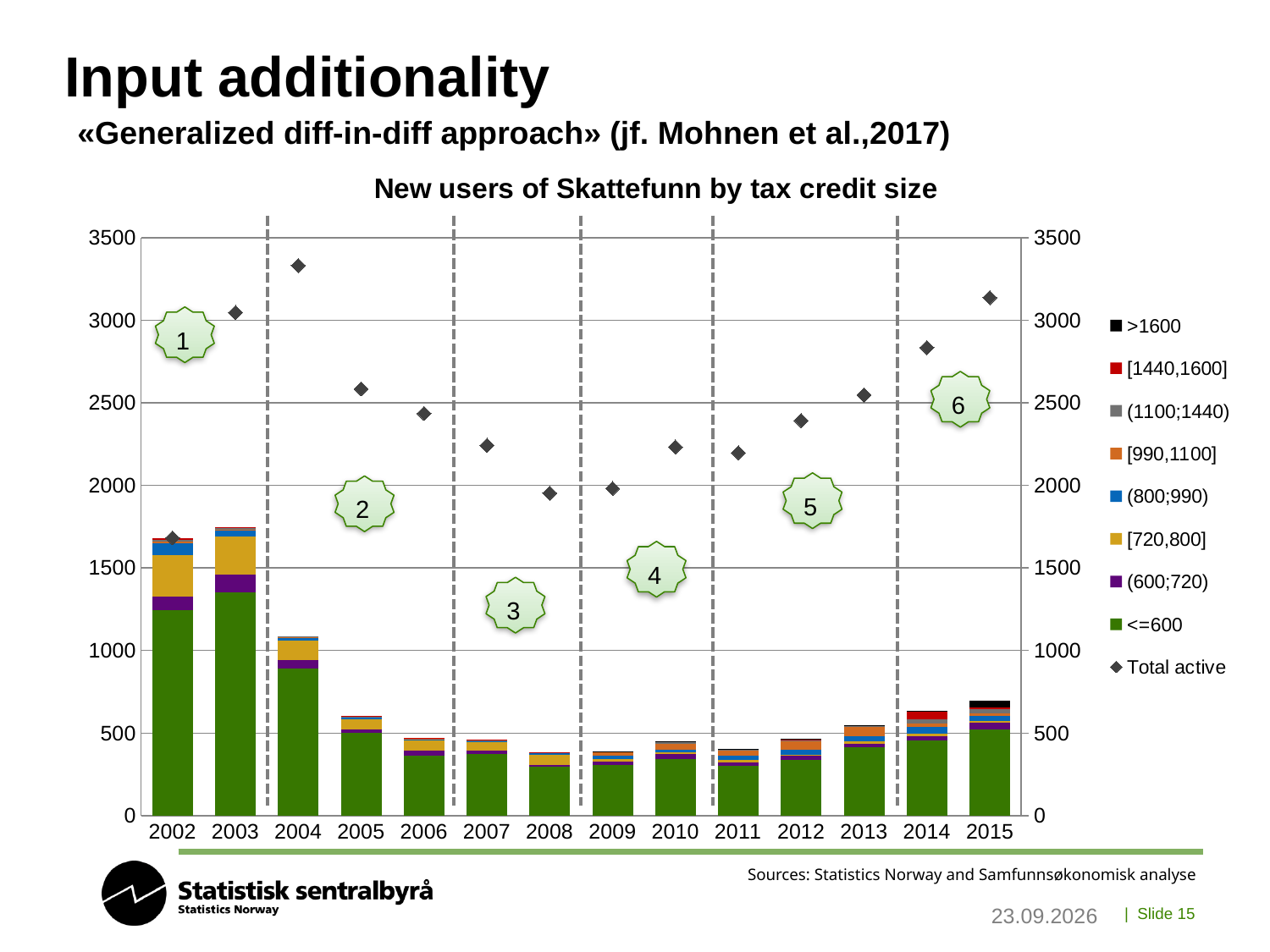
What is the title of the chart? New users of Skattefunn by tax credit size Is the total height of the stacked bar for 2002 greater or less than 1500? greater Which is larger, the Total active value for 2004 or for 2005? 2004 What kind of chart is shown on the slide? Stacked bar chart with a marker series Which year has the highest value for Total active? 2004 Does the Total active series rise or fall from 2004 to 2008? fall Is the Total active value for 2008 greater or less than 2000? less How many series does the legend list? 9 Which legend entry is shown in green, the largest segment of each stacked bar? <=600 Is the Total active value for 2004 greater or less than 3000? greater How many years are shown on the x axis of the chart? 14